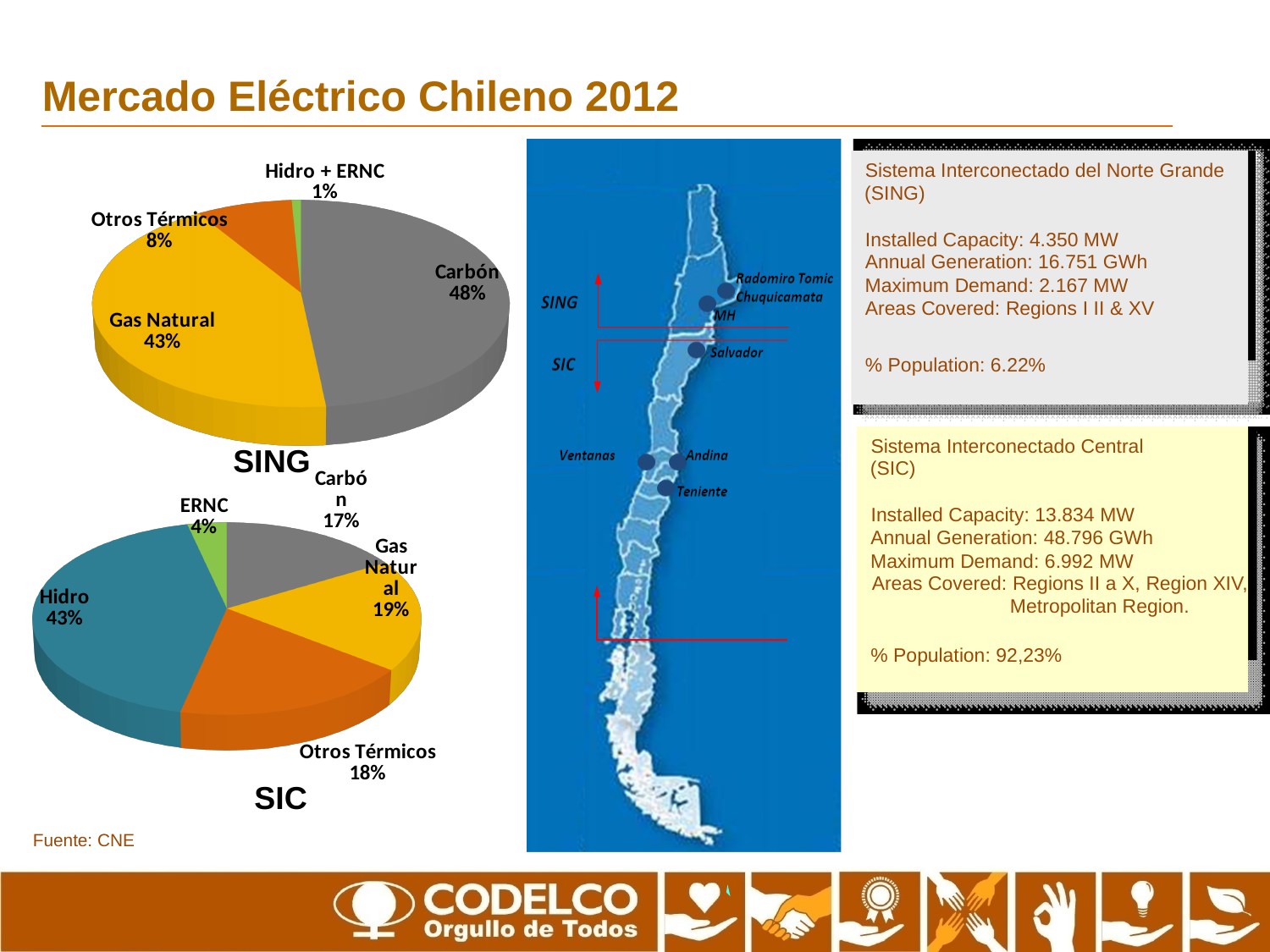
In the SIC pie chart, which category has the smallest share? ERNC In the SIC pie chart, which category has the largest share? Hidro In the SING pie chart, what share does Carbón have? 48% In the SING pie chart, which category has the largest share? Carbón In the SING pie chart, how many categories are shown? 4 In the SIC pie chart, what share does Otros Térmicos have? 18% What type of chart is used for the SING and SIC data? Pie chart In the SING pie chart, what share does Gas Natural have? 43% In the SIC pie chart, what share does Hidro have? 43% In the SIC pie chart, what is the difference between the Gas Natural share and the Carbón share? 2% In the SIC pie chart, how many categories are shown? 5 In the SING pie chart, which category has the smallest share? Hidro + ERNC